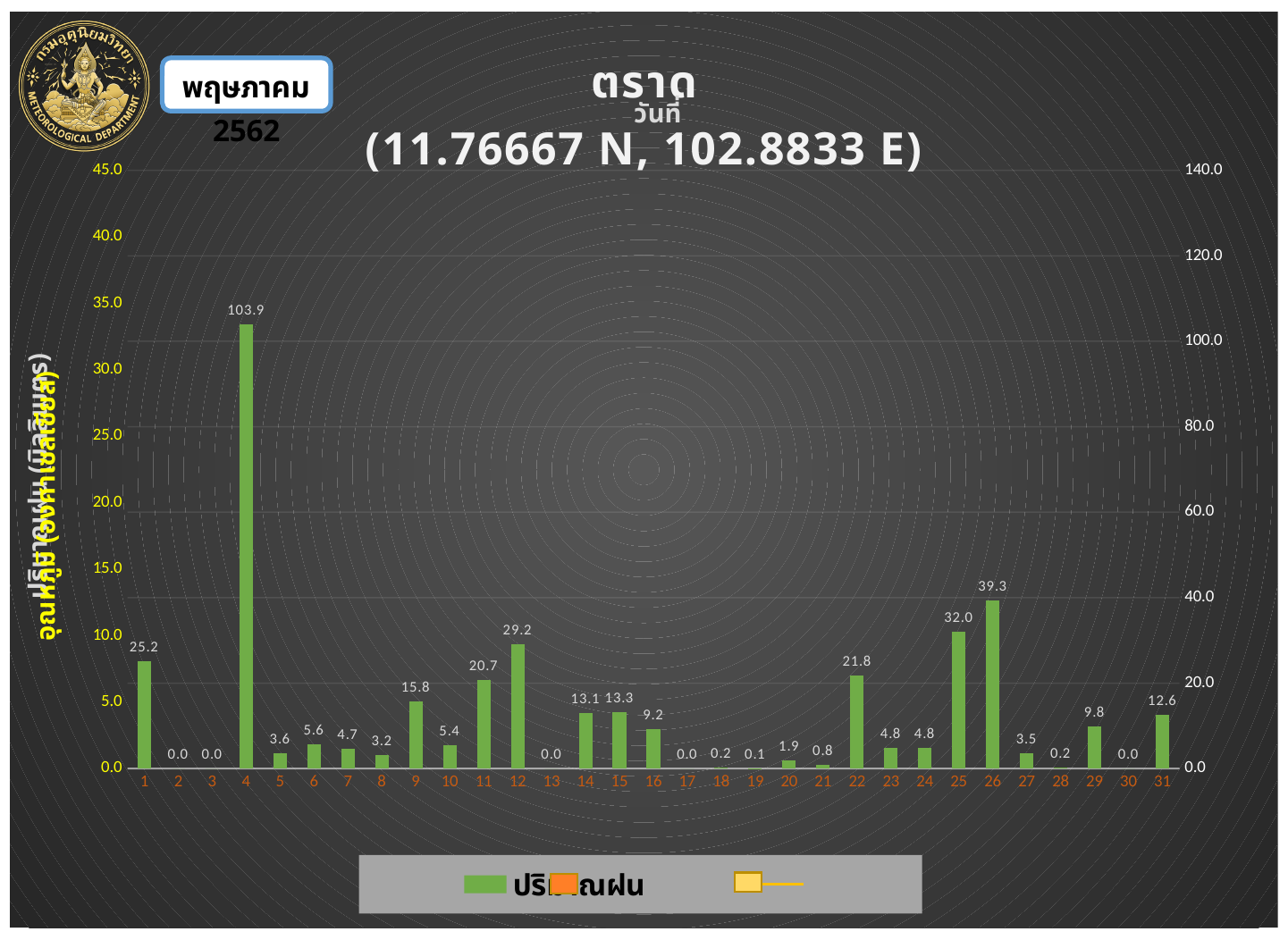
What is the difference between the values for day 26 and day 25? 7.3 What is the difference between the values for day 12 and day 1? 4.0 What kind of chart is this? bar chart Which day has the highest value? 4 Which is larger, the value for day 9 or the value for day 16? day 9 What is the label of the green bar series in the legend? ปริมาณฝน What is the value for day 12? 29.2 What is the value for day 26? 39.3 Which is larger, the value for day 22 or the value for day 11? day 22 What is the value for day 4? 103.9 What is the value for day 22? 21.8 How many days are shown on the x axis? 31